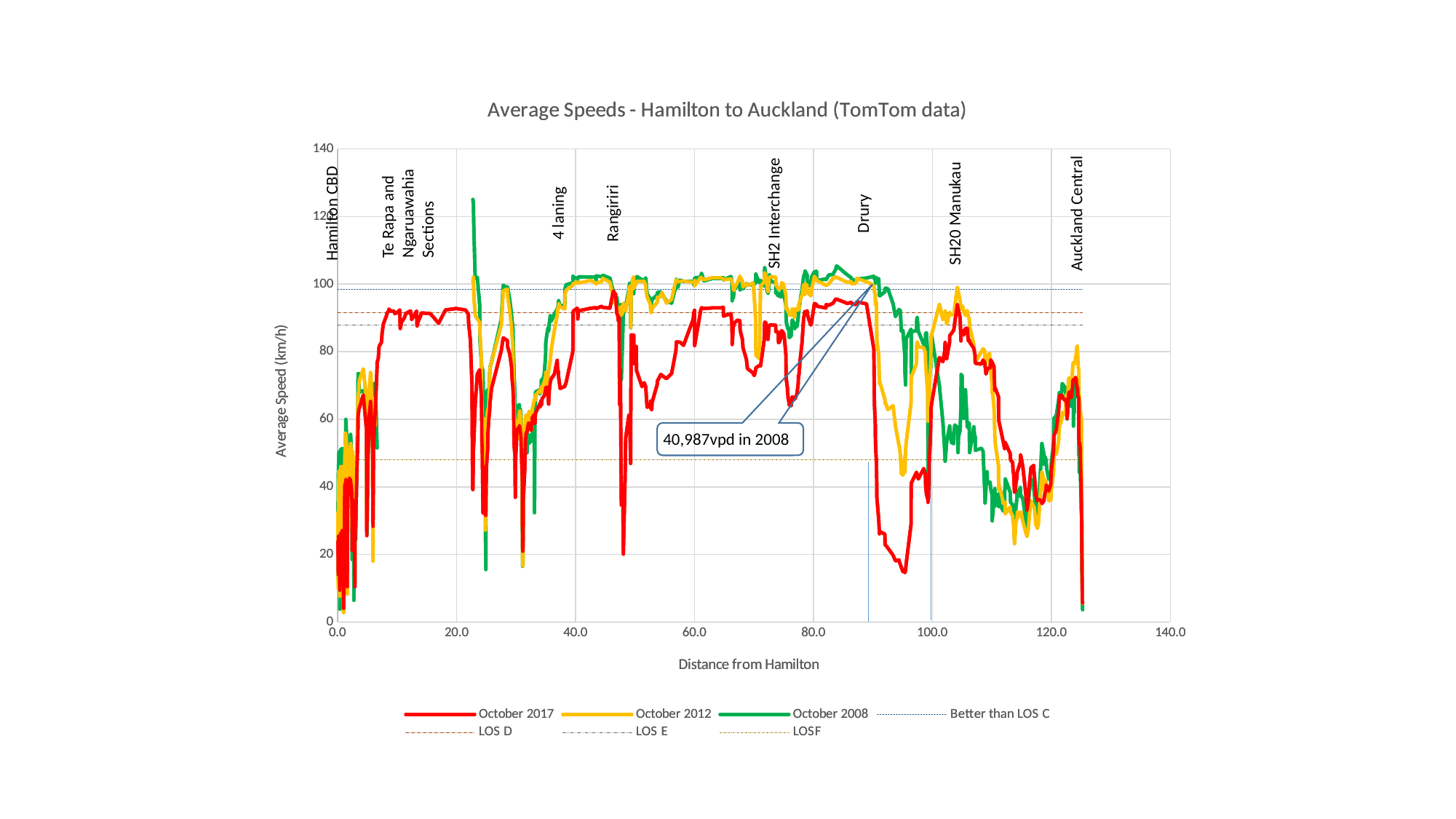
What does the annotation box on the chart say? 40,987vpd in 2008 At the 40 km mark, which series shows the higher speed, October 2008 or October 2017? October 2008 Is the peak of the October 2008 line near the 22 km mark greater or less than 120? greater Is the October 2008 speed at the 110 km mark greater or less than 60? less Is the October 2012 speed at the 60 km mark greater or less than 80? greater What kind of chart is shown on the slide? line chart Near the 95 km mark, which series shows the higher speed, October 2008 or October 2017? October 2008 What is the title of the chart? Average Speeds - Hamilton to Auckland (TomTom data) Between the 100 km and 110 km marks, does the October 2008 line rise or fall? fall How many entries does the chart's legend list? 7